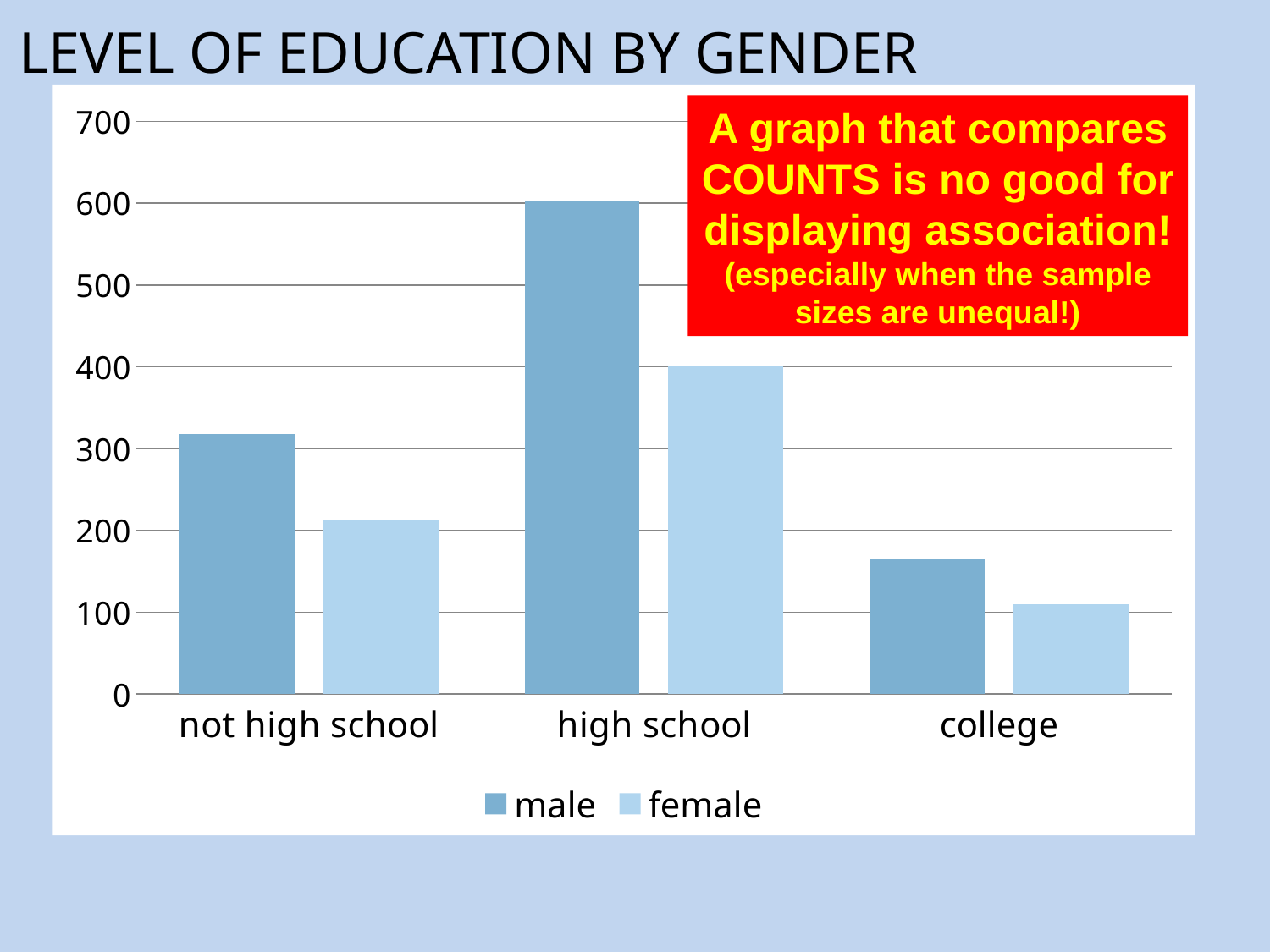
Which education level has the lowest female count? college What kind of chart is shown on the slide? bar chart Which education level has the highest male count? high school Which is larger, the female count for high school or the female count for not high school? high school Is the male count for high school greater or less than 500? greater What is the title of the slide? LEVEL OF EDUCATION BY GENDER What are the two series named in the legend? male and female In the not high school category, which is larger, the male or the female count? male Is the female count for not high school greater or less than 300? less Is the male count for college greater or less than 200? less How many series does the legend list? 2 How many education-level categories are shown on the x axis? 3